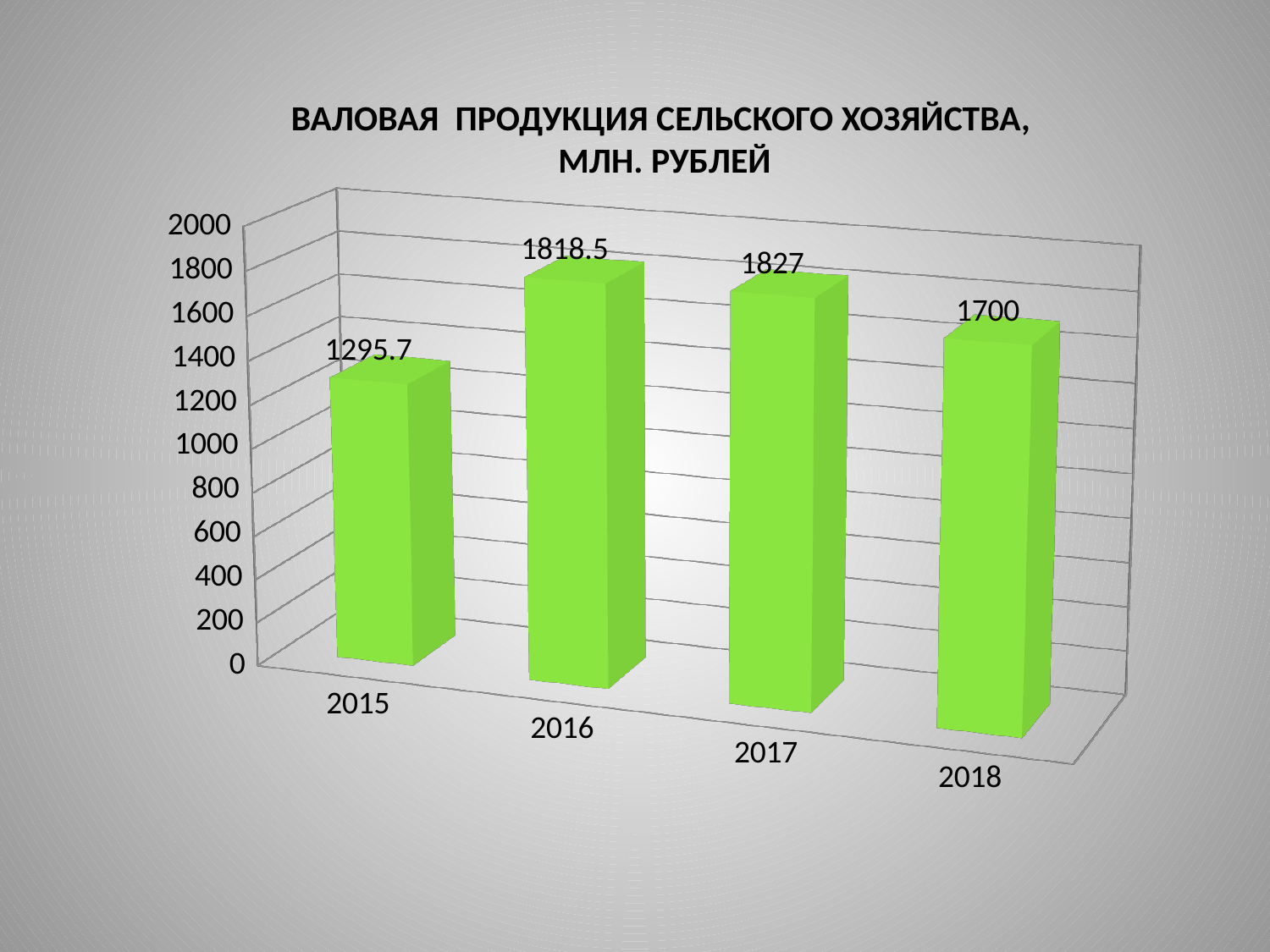
Does the value rise or fall from 2017 to 2018? fall Which year has the highest value? 2017 What is the value for 2016? 1818.5 How many years are shown on the chart? 4 Which year has the lowest value? 2015 What is the value for 2017? 1827 What is the value for 2018? 1700 What is the value for 2015? 1295.7 Which is larger, the value for 2018 or the value for 2015? 2018 What is the difference between the values for 2016 and 2015? 522.8 What is the difference between the values for 2017 and 2018? 127 What kind of chart is this? bar chart